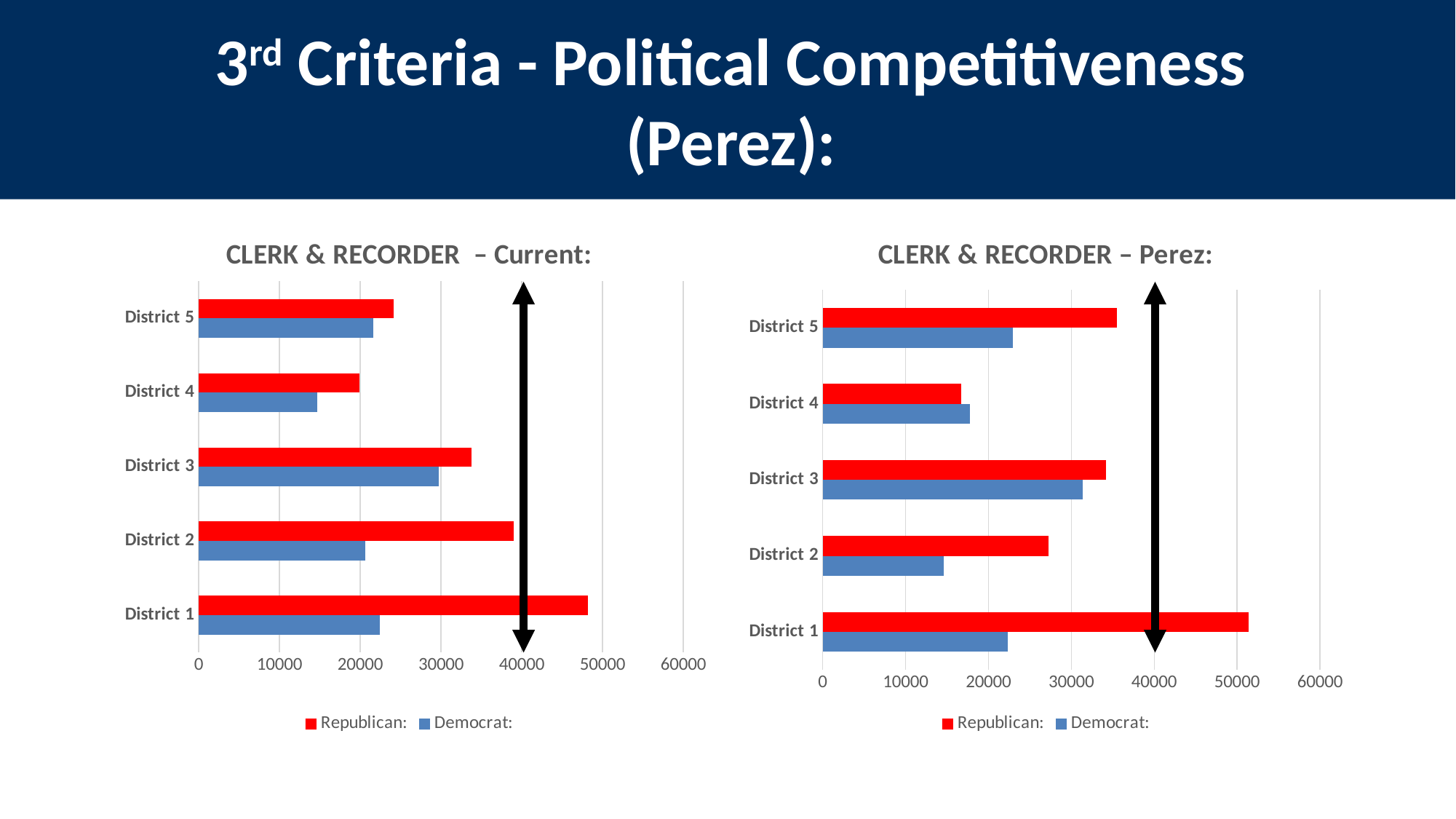
In the 'CLERK & RECORDER – Perez:' chart, which district has the highest Republican value? District 1 In the 'CLERK & RECORDER – Perez:' chart, is the Republican value for District 5 greater or less than 30000? greater In the 'CLERK & RECORDER – Perez:' chart, which district has the lowest Republican value? District 4 In the 'CLERK & RECORDER – Current:' chart, which district has the lowest Democrat value? District 4 In the 'CLERK & RECORDER – Current:' chart, which district has the highest Republican value? District 1 In the 'CLERK & RECORDER – Perez:' chart, which is larger for District 2, the Republican value or the Democrat value? Republican In the 'CLERK & RECORDER – Current:' chart, is the Republican value for District 1 greater or less than 40000? greater How many series does the legend of the 'CLERK & RECORDER – Perez:' chart list? 2 What kind of chart is the 'CLERK & RECORDER – Current:' chart? bar chart How many districts are shown in the 'CLERK & RECORDER – Current:' chart? 5 In the 'CLERK & RECORDER – Current:' chart, is the Democrat value for District 3 greater or less than 20000? greater